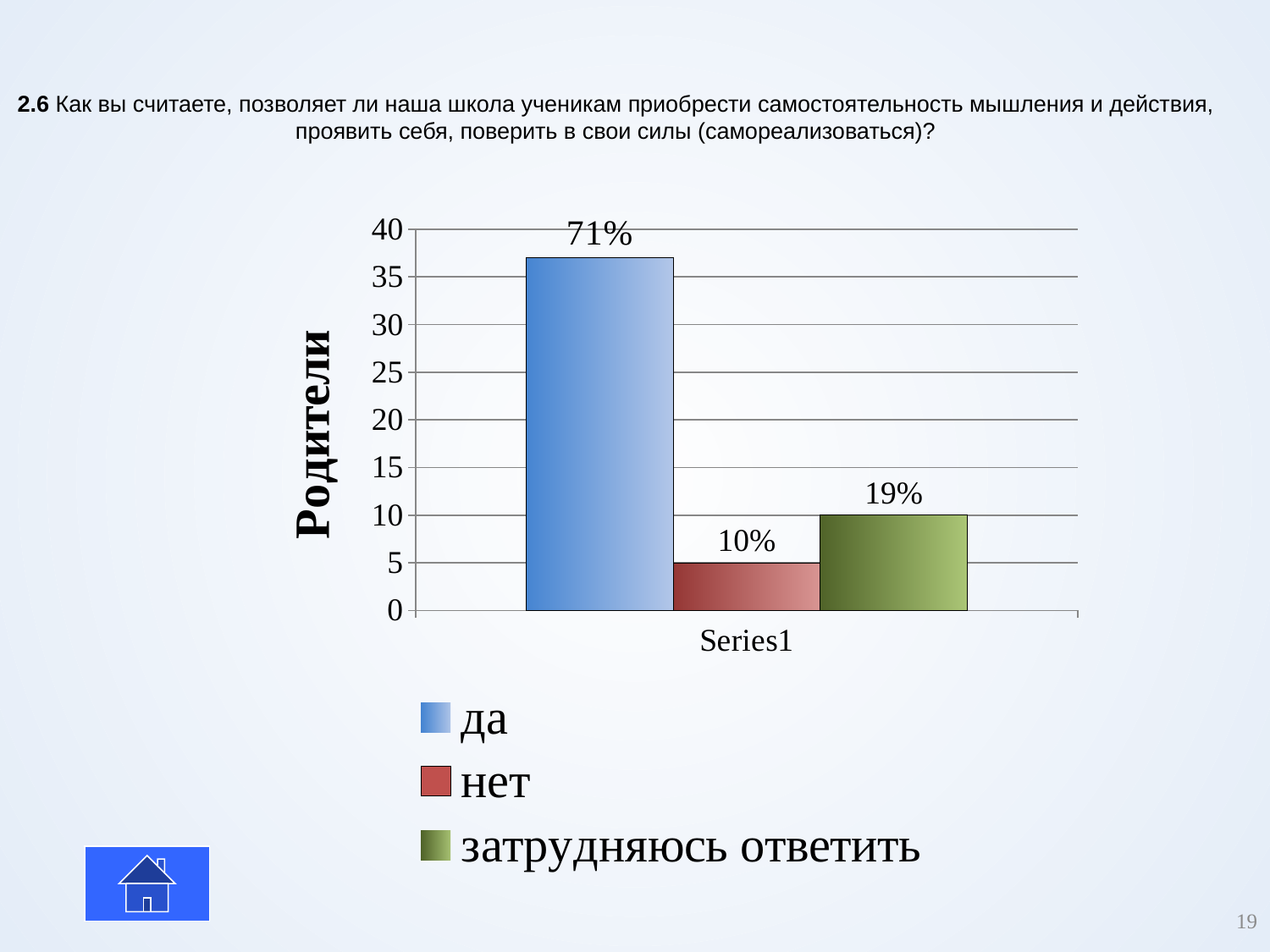
What is the difference between the data labels for "затрудняюсь ответить" and "нет"? 9% What data label is shown on the bar for "да"? 71% What is the title of the vertical axis? Родители What data label is shown on the bar for "нет"? 10% Which answer option has the highest bar? да Is the bar for "да" greater or less than 35 on the vertical axis? greater What kind of chart is shown on the slide? bar chart What is the difference between the data labels for "да" and "нет"? 61% Which answer option has the lowest bar? нет How many series does the legend list? 3 What data label is shown on the bar for "затрудняюсь ответить"? 19% Which is larger, the bar for "нет" or the bar for "затрудняюсь ответить"? затрудняюсь ответить